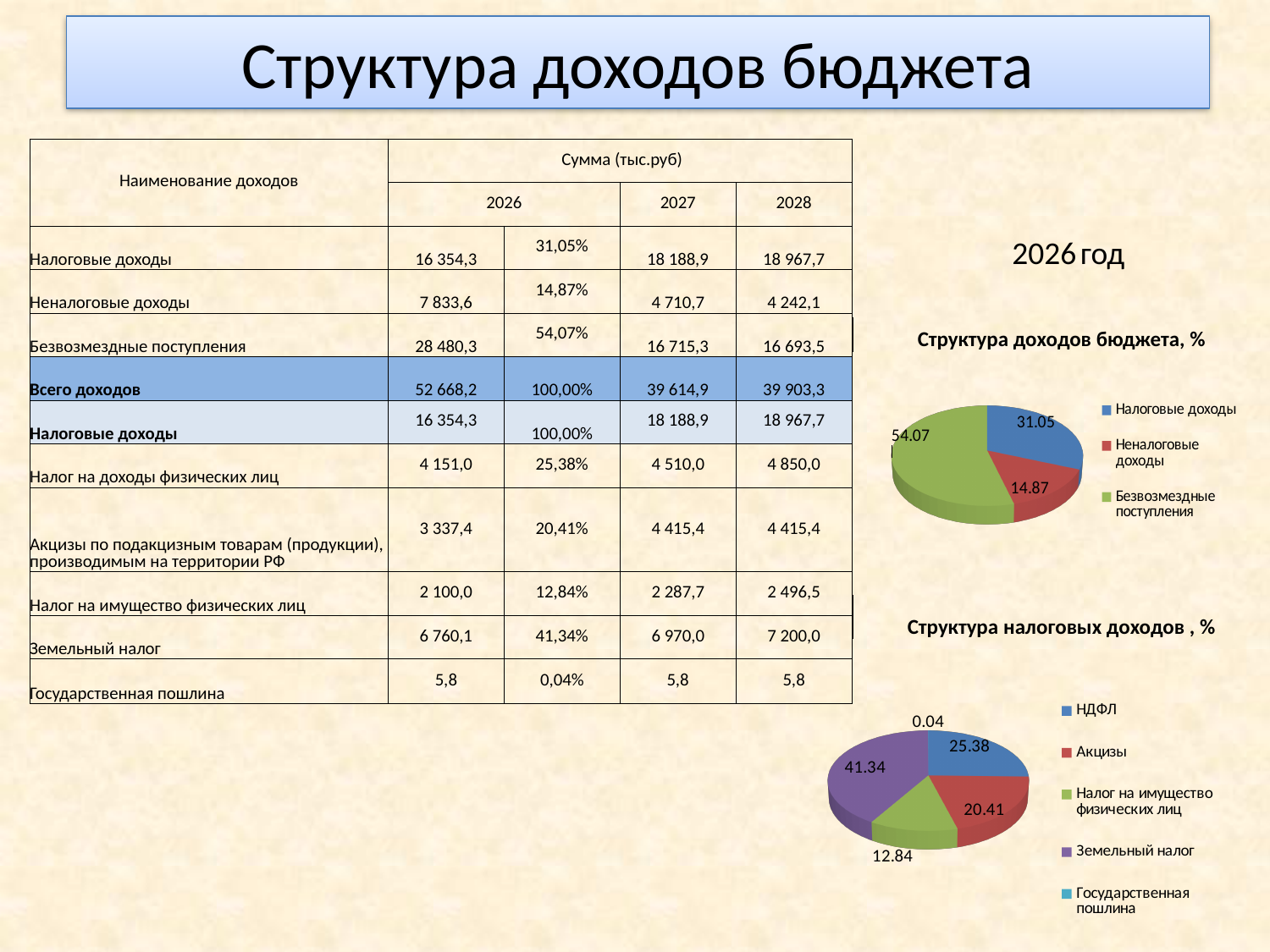
In the chart 'Структура налоговых доходов , %', what is the value for Земельный налог? 41.34 In the chart 'Структура доходов бюджета, %', what is the difference between the values for Безвозмездные поступления and Налоговые доходы? 23.02 In the chart 'Структура доходов бюджета, %', what is the value for Безвозмездные поступления? 54.07 In the chart 'Структура доходов бюджета, %', what is the value for Неналоговые доходы? 14.87 In the chart 'Структура налоговых доходов , %', how many categories does the legend list? 5 What kind of chart is 'Структура налоговых доходов , %'? Pie chart In the chart 'Структура налоговых доходов , %', which category has the largest slice? Земельный налог In the chart 'Структура доходов бюджета, %', which category has the smallest slice? Неналоговые доходы In the chart 'Структура налоговых доходов , %', which is larger, НДФЛ or Акцизы? НДФЛ In the chart 'Структура налоговых доходов , %', what is the value for Государственная пошлина? 0.04 In the chart 'Структура доходов бюджета, %', how many categories does the legend list? 3 In the chart 'Структура доходов бюджета, %', which category has the largest slice? Безвозмездные поступления